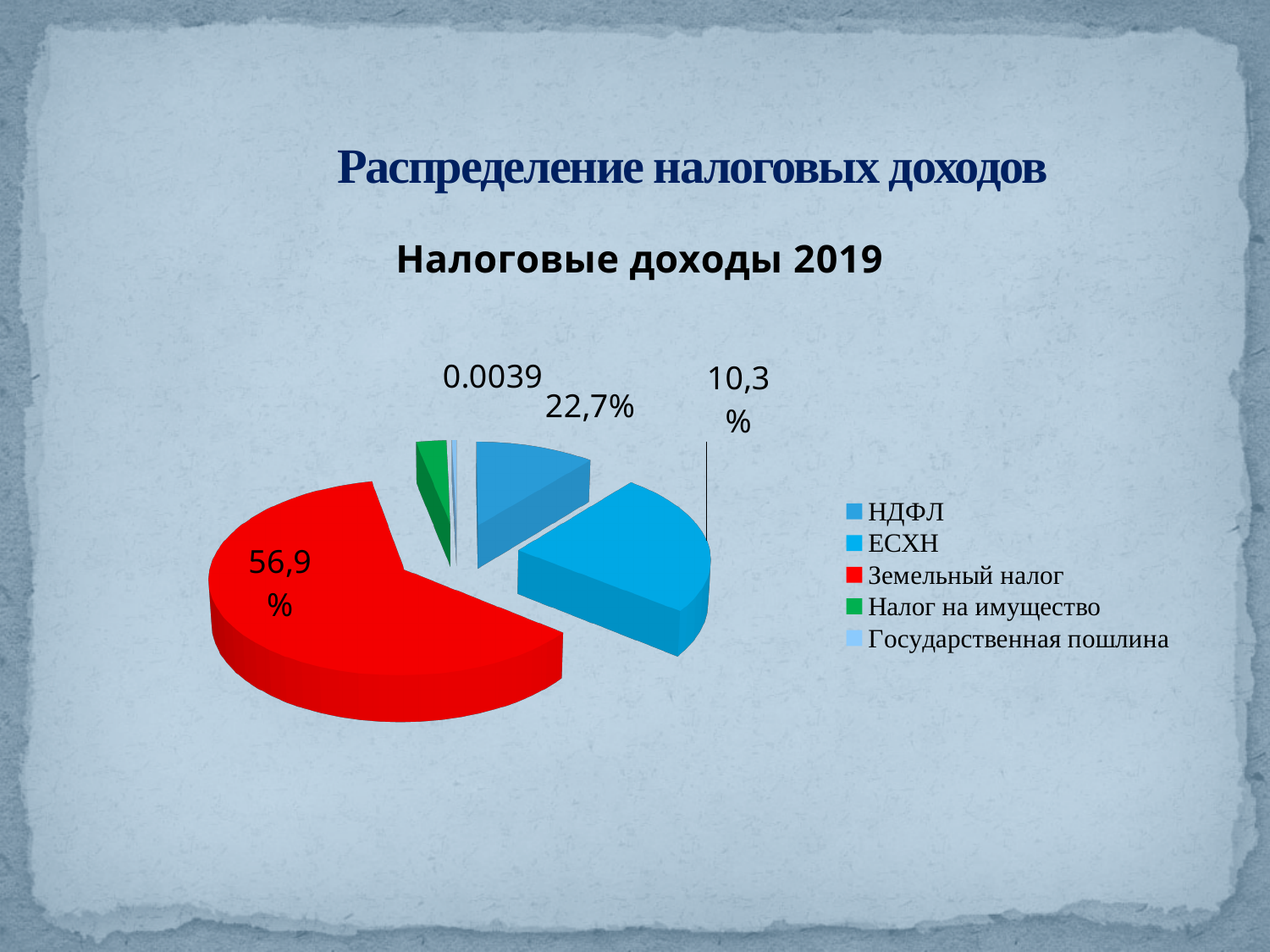
What colour is the slice for Земельный налог? red Which category has the largest slice of the pie? Земельный налог How many slices does the pie chart have? 5 How many entries does the chart legend list? 5 What share of the pie does Земельный налог have? 56,9% Which is larger, the slice for Земельный налог or the slice for НДФЛ? Земельный налог Is the share for Земельный налог greater or less than 50%? greater Which is larger, the slice for Земельный налог or the slice for ЕСХН? Земельный налог Which category has the smallest slice of the pie? Государственная пошлина What kind of chart is shown on the slide? pie chart What is the title of the chart? Налоговые доходы 2019